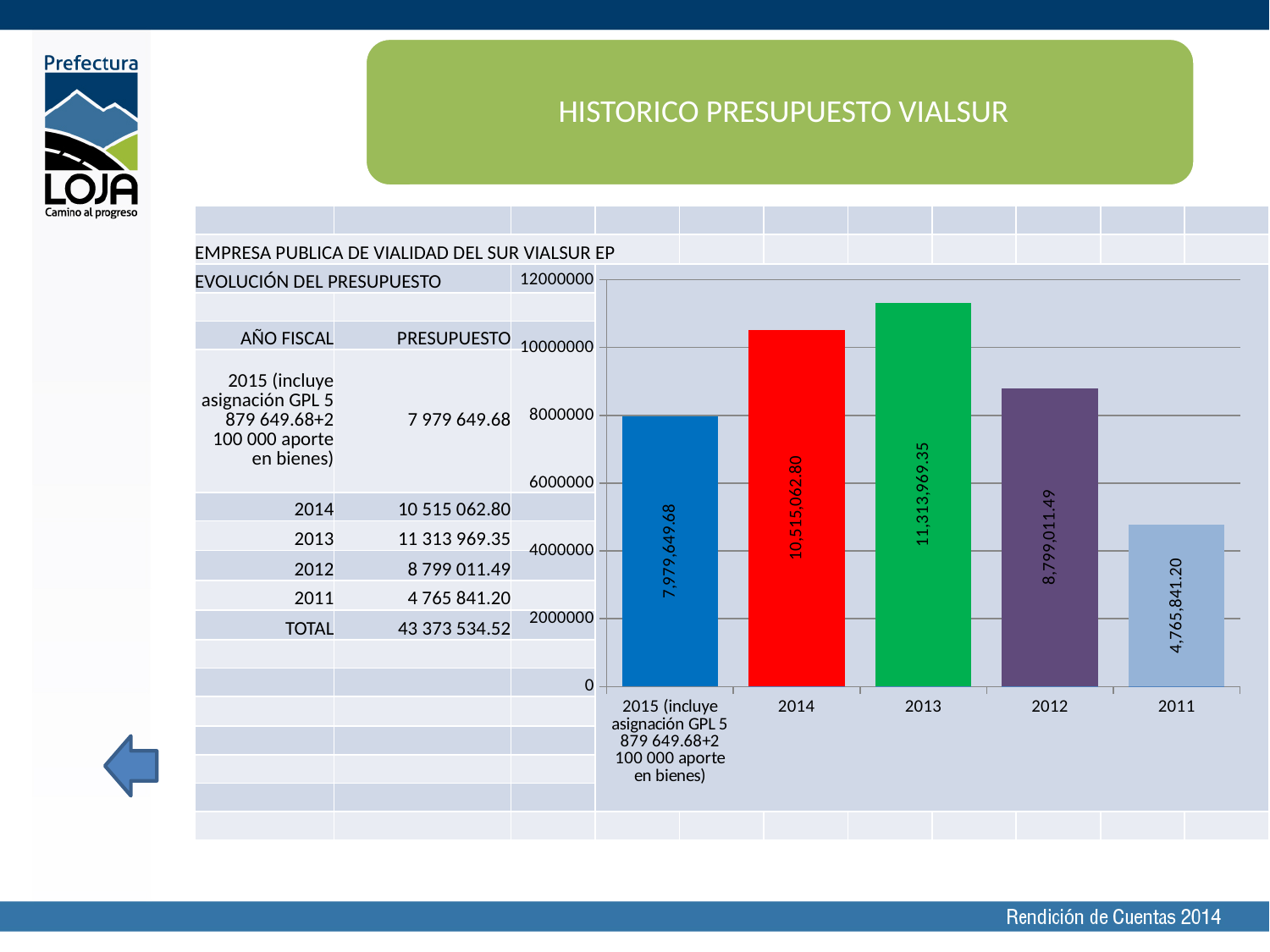
Is the value for 2013 greater or less than 10000000? greater How many bars are shown in the chart? 5 What is the value of the bar for 2011? 4,765,841.20 What is the difference between the values for 2012 and 2011? 4,033,170.29 Which is larger, the value for 2014 or the value for 2012? 2014 What type of chart is shown on the slide? bar chart What is the value of the bar for 2014? 10,515,062.80 What is the value of the bar for 2012? 8,799,011.49 Which year has the lowest bar? 2011 What colour is the bar for 2014? red Which year has the highest bar? 2013 What is the difference between the values for 2013 and 2014? 798,906.55